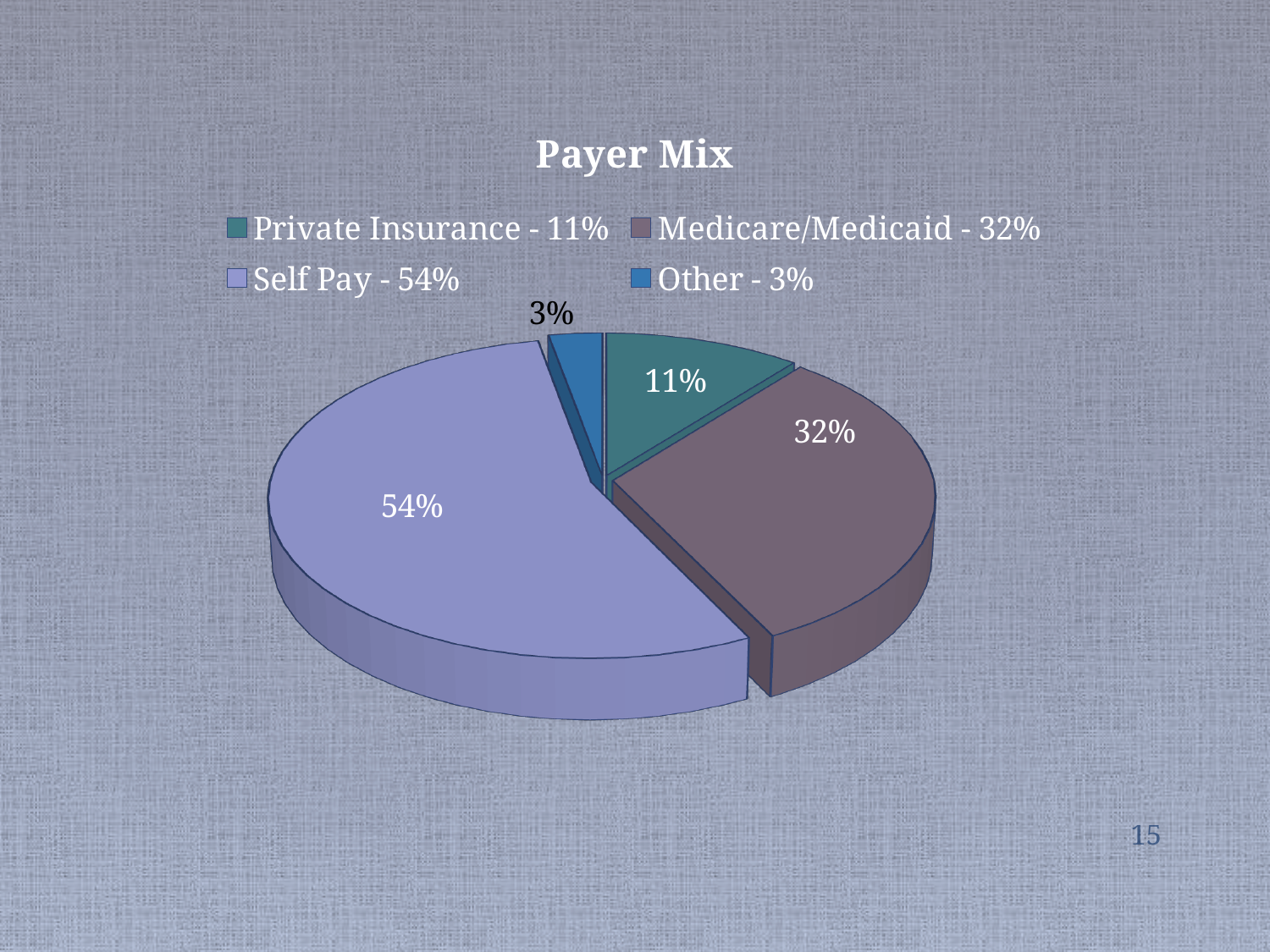
Which category has the largest share of the pie? Self Pay What is the difference between the Private Insurance and Other shares? 8% Which is larger, Private Insurance or Medicare/Medicaid? Medicare/Medicaid How many categories are shown in the pie chart? 4 What is the difference between the Self Pay and Medicare/Medicaid shares? 22% Which category has the smallest share of the pie? Other What is the value for Other? 3% What kind of chart is shown on the slide? Pie chart What is the title of the chart? Payer Mix What is the value for Medicare/Medicaid? 32% What share of the pie does Self Pay represent? 54% What is the value for Private Insurance? 11%